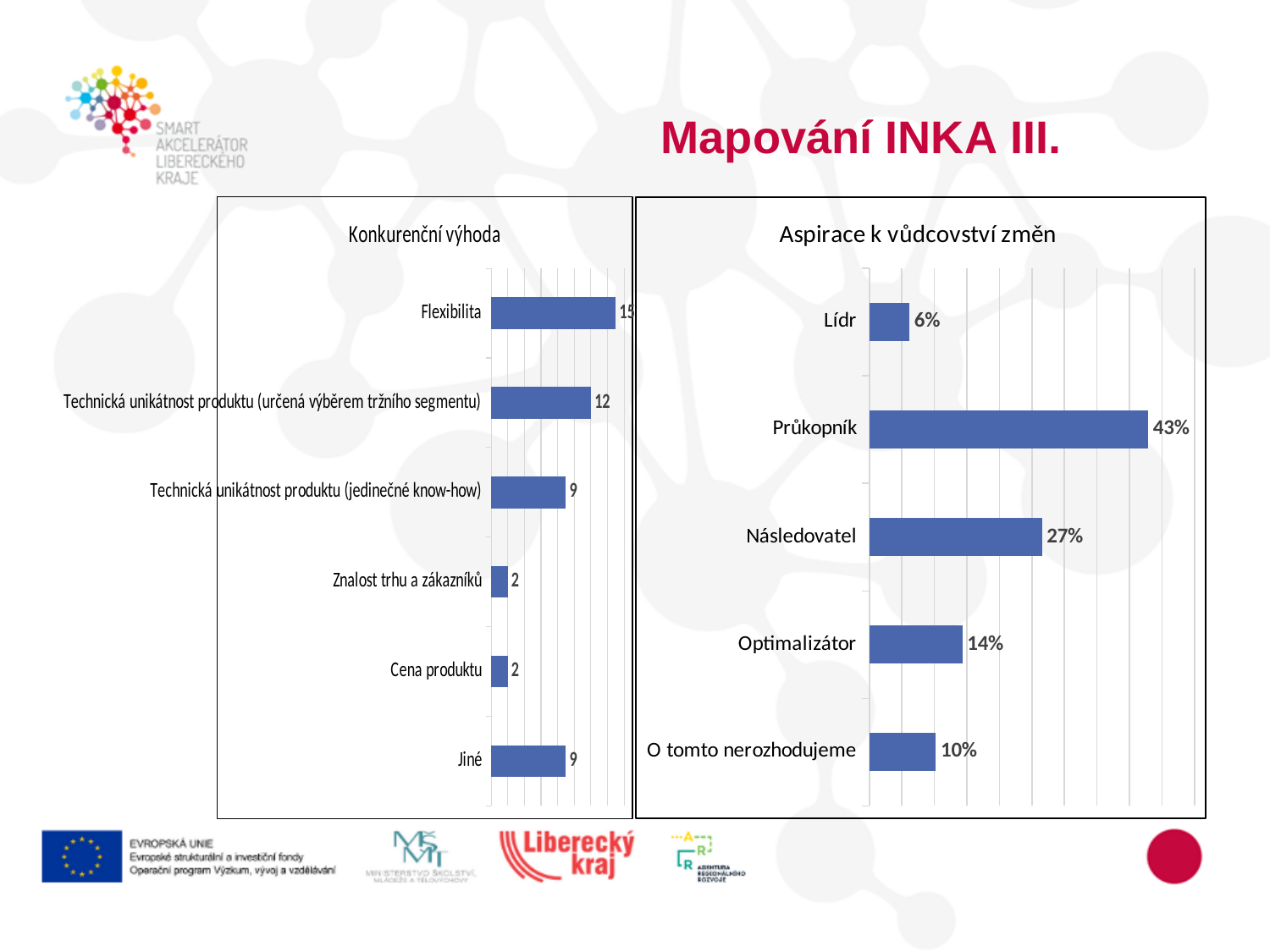
In the 'Konkurenční výhoda' chart, what is the difference between Flexibilita and Jiné? 6 In the 'Aspirace k vůdcovství změn' chart, what is the difference between Průkopník and Následovatel? 16% In the 'Konkurenční výhoda' chart, which category has the highest value? Flexibilita In the 'Aspirace k vůdcovství změn' chart, how many categories are shown? 5 In the 'Aspirace k vůdcovství změn' chart, what is the value for Lídr? 6% In the 'Aspirace k vůdcovství změn' chart, what is the value for Průkopník? 43% What type of chart is the 'Aspirace k vůdcovství změn' chart? Bar chart In the 'Konkurenční výhoda' chart, what is the value for Technická unikátnost produktu (určená výběrem tržního segmentu)? 12 In the 'Konkurenční výhoda' chart, how many categories are shown? 6 In the 'Aspirace k vůdcovství změn' chart, which category has the lowest value? Lídr In the 'Konkurenční výhoda' chart, what is the value for Flexibilita? 15 In the 'Aspirace k vůdcovství změn' chart, which is larger: Následovatel or Optimalizátor? Následovatel